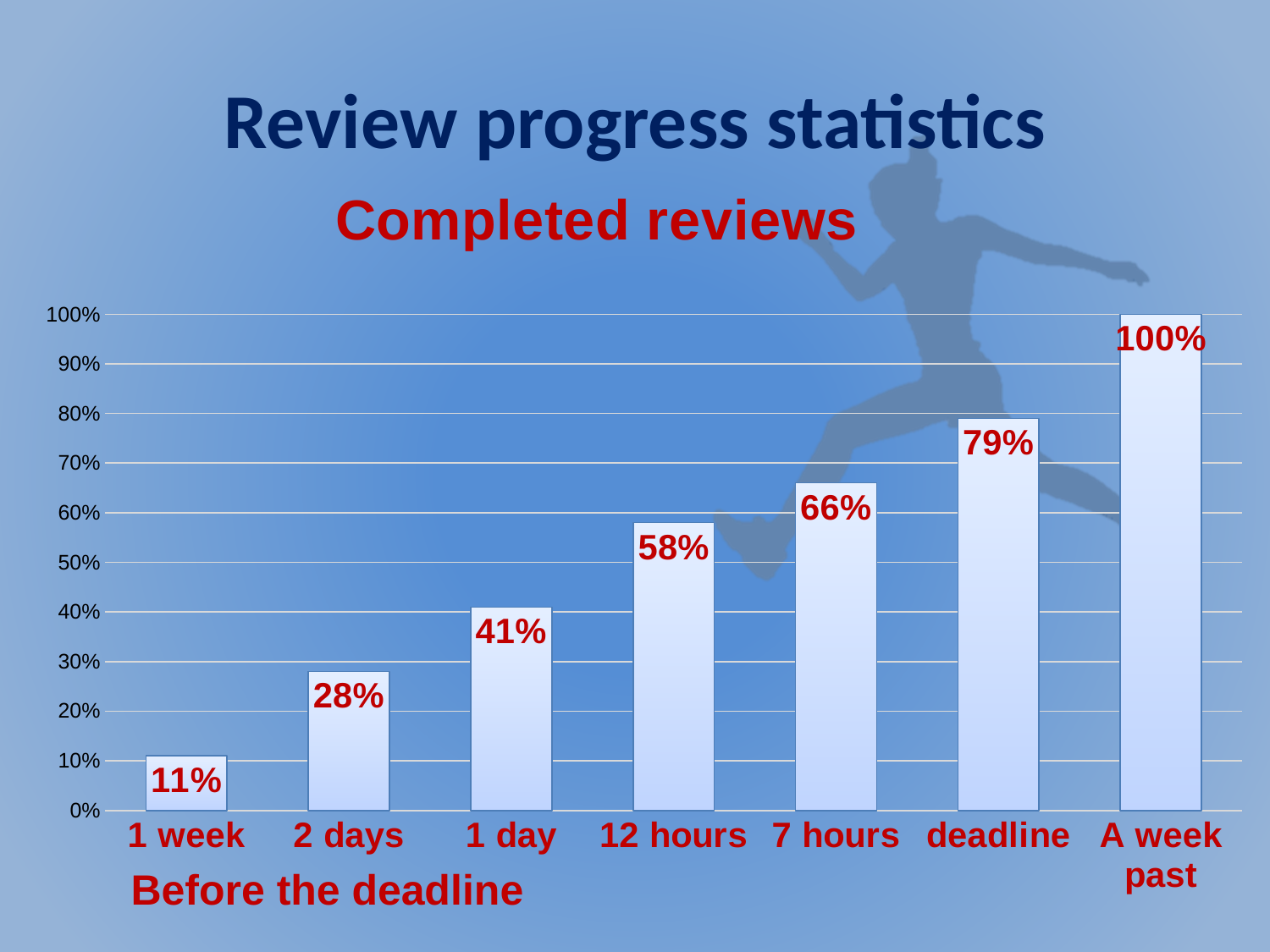
What is the value for 12 hours? 58% Which category has the lowest value? 1 week Is the value for 7 hours greater or less than 60%? greater Which is larger, the value for 2 days or the value for 1 day? 1 day What is the value for deadline? 79% What is the value for 1 day? 41% How many categories are shown on the x axis? 7 What is the difference between the values for deadline and 2 days? 51% What kind of chart is shown? Bar chart Which category has the highest value? A week past Do the values rise or fall from left to right along the x axis? Rise What is the difference between the values for 7 hours and 12 hours? 8%